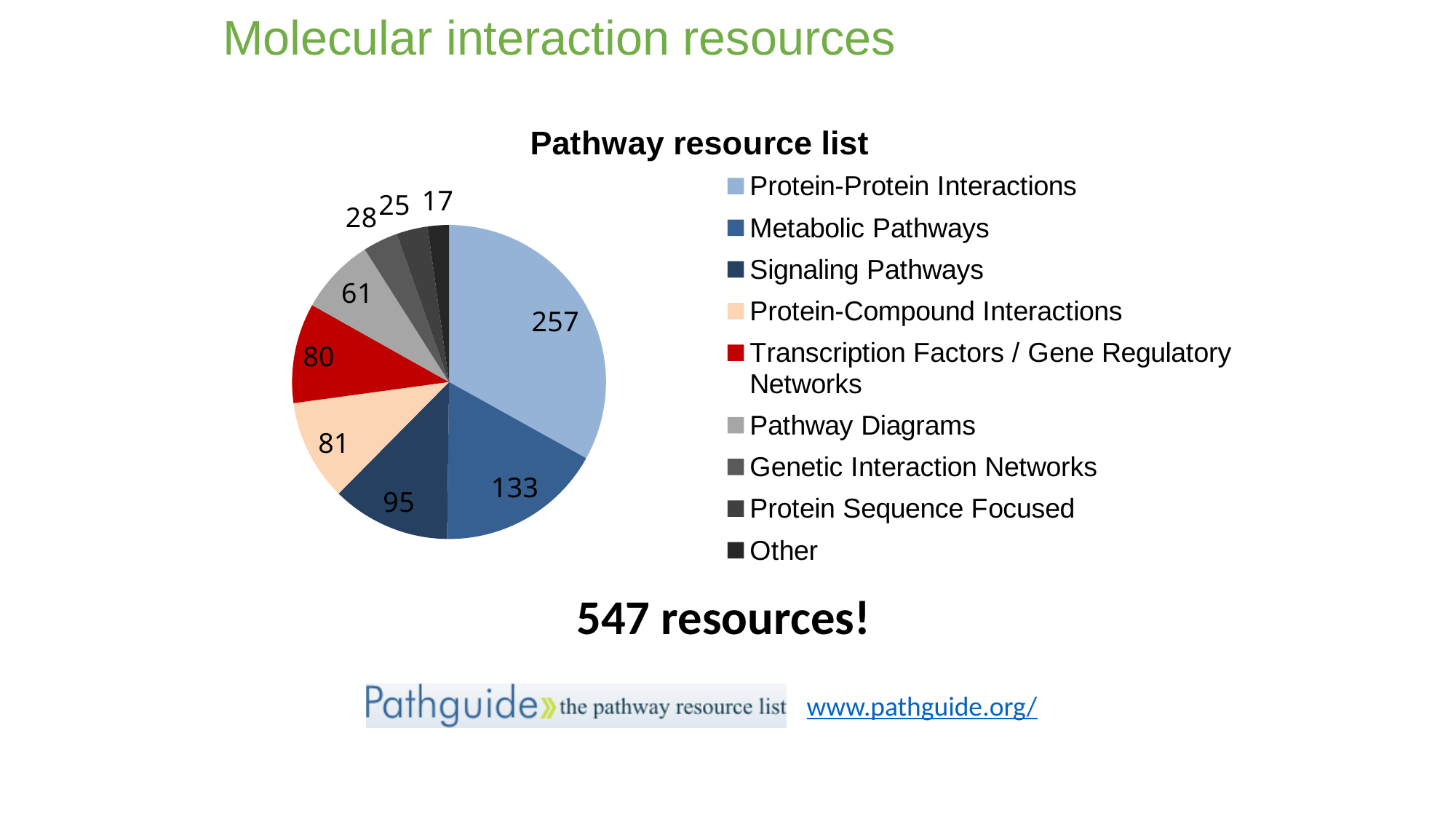
What is the title of the chart? Pathway resource list Which category has the largest slice of the pie? Protein-Protein Interactions What is the value for Pathway Diagrams? 61 What type of chart is shown on the slide? pie chart What is the value for Protein-Protein Interactions? 257 What is the difference between the values for Protein-Protein Interactions and Metabolic Pathways? 124 What is the value for Other? 17 How many categories does the pie chart have? 9 Which is larger, the value for Signaling Pathways or the value for Pathway Diagrams? Signaling Pathways Which category has the smallest slice of the pie? Other What is the value for Signaling Pathways? 95 What is the value for Metabolic Pathways? 133